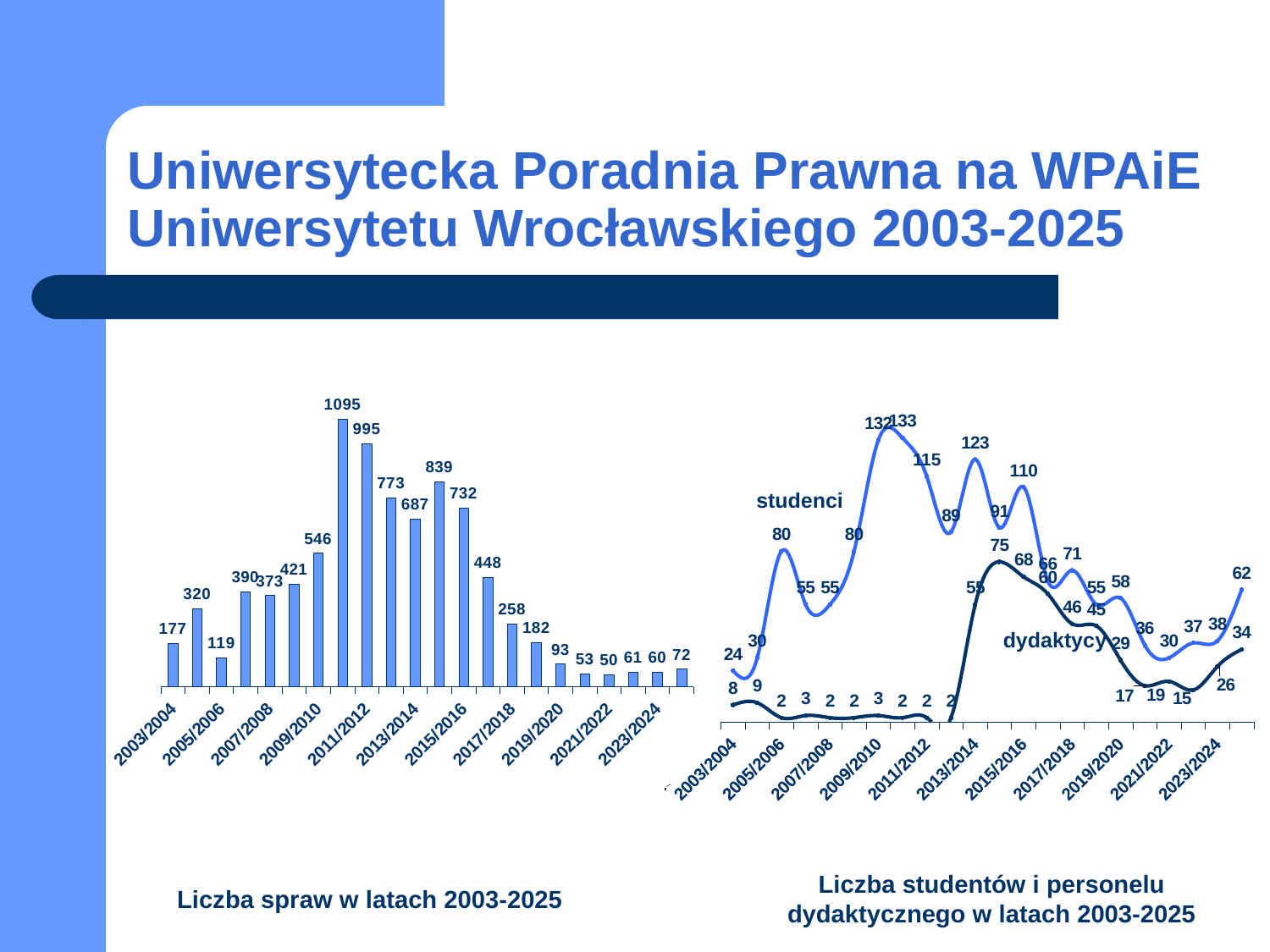
In the left chart 'Liczba spraw w latach 2003-2025', how many bars are plotted? 22 In the right chart, what is the highest value of the 'dydaktycy' series? 75 In the left chart 'Liczba spraw w latach 2003-2025', what is the highest value shown? 1095 In the right chart, what is the 'studenci' value for 2003/2004? 24 In the left chart 'Liczba spraw w latach 2003-2025', what is the value for 2003/2004? 177 In the left chart 'Liczba spraw w latach 2003-2025', which has the larger value, 2005/2006 or 2007/2008? 2007/2008 How many series are plotted in the right chart 'Liczba studentów i personelu dydaktycznego w latach 2003-2025'? 2 In the right chart, what is the highest value of the 'studenci' series? 133 What kind of chart is the left chart, 'Liczba spraw w latach 2003-2025'? bar chart What kind of chart is the right chart, 'Liczba studentów i personelu dydaktycznego w latach 2003-2025'? line chart In the left chart 'Liczba spraw w latach 2003-2025', what is the difference between the two tallest bars, 1095 and 995? 100 In the left chart 'Liczba spraw w latach 2003-2025', what is the lowest value shown? 50